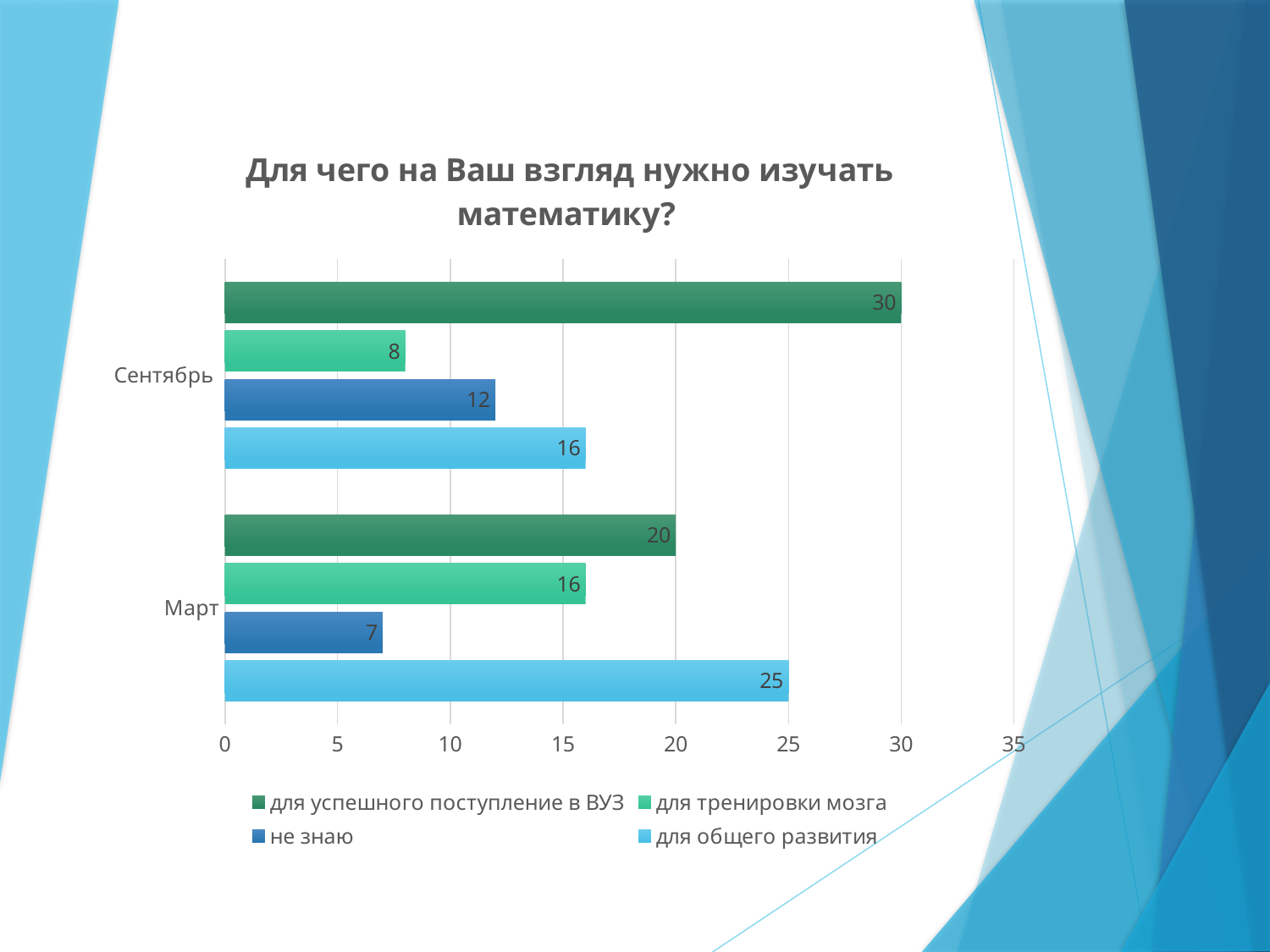
What is the value for "не знаю" in Март? 7 How many categories are shown on the vertical axis? 2 Which is larger: "не знаю" in Сентябрь or "не знаю" in Март? Сентябрь What is the value for "для тренировки мозга" in Сентябрь? 8 What type of chart is shown on the slide? bar chart What is the value for "для общего развития" in Март? 25 What is the value for "для успешного поступление в ВУЗ" in Сентябрь? 30 Which series has the highest value in Март? для общего развития What is the title of the chart? Для чего на Ваш взгляд нужно изучать математику? How many series does the legend list? 4 Which series has the lowest value in Сентябрь? для тренировки мозга What is the difference between the "для успешного поступление в ВУЗ" values for Сентябрь and Март? 10